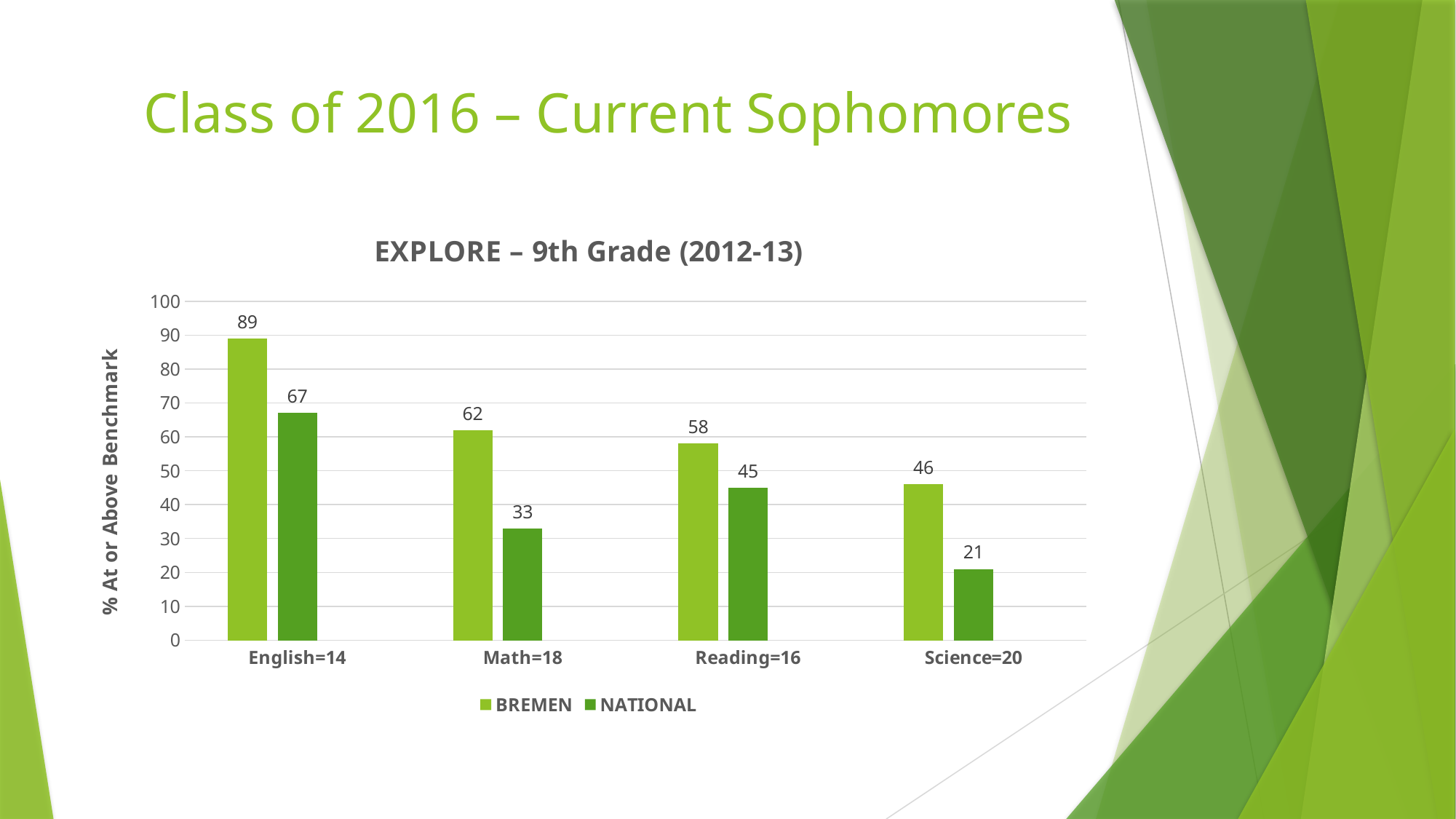
What kind of chart is shown on the slide? bar chart What is the difference between the BREMEN and NATIONAL values for Math=18? 29 What is the title of the chart? EXPLORE – 9th Grade (2012-13) Which category has the lowest NATIONAL value? Science=20 Do the BREMEN values rise or fall from English=14 to Science=20? fall Which is larger for Reading=16, the BREMEN value or the NATIONAL value? BREMEN Which category has the highest BREMEN value? English=14 What is the NATIONAL value for Science=20? 21 How many categories are shown on the x axis? 4 What is the NATIONAL value for Math=18? 33 What is the BREMEN value for English=14? 89 How many series does the legend list? 2